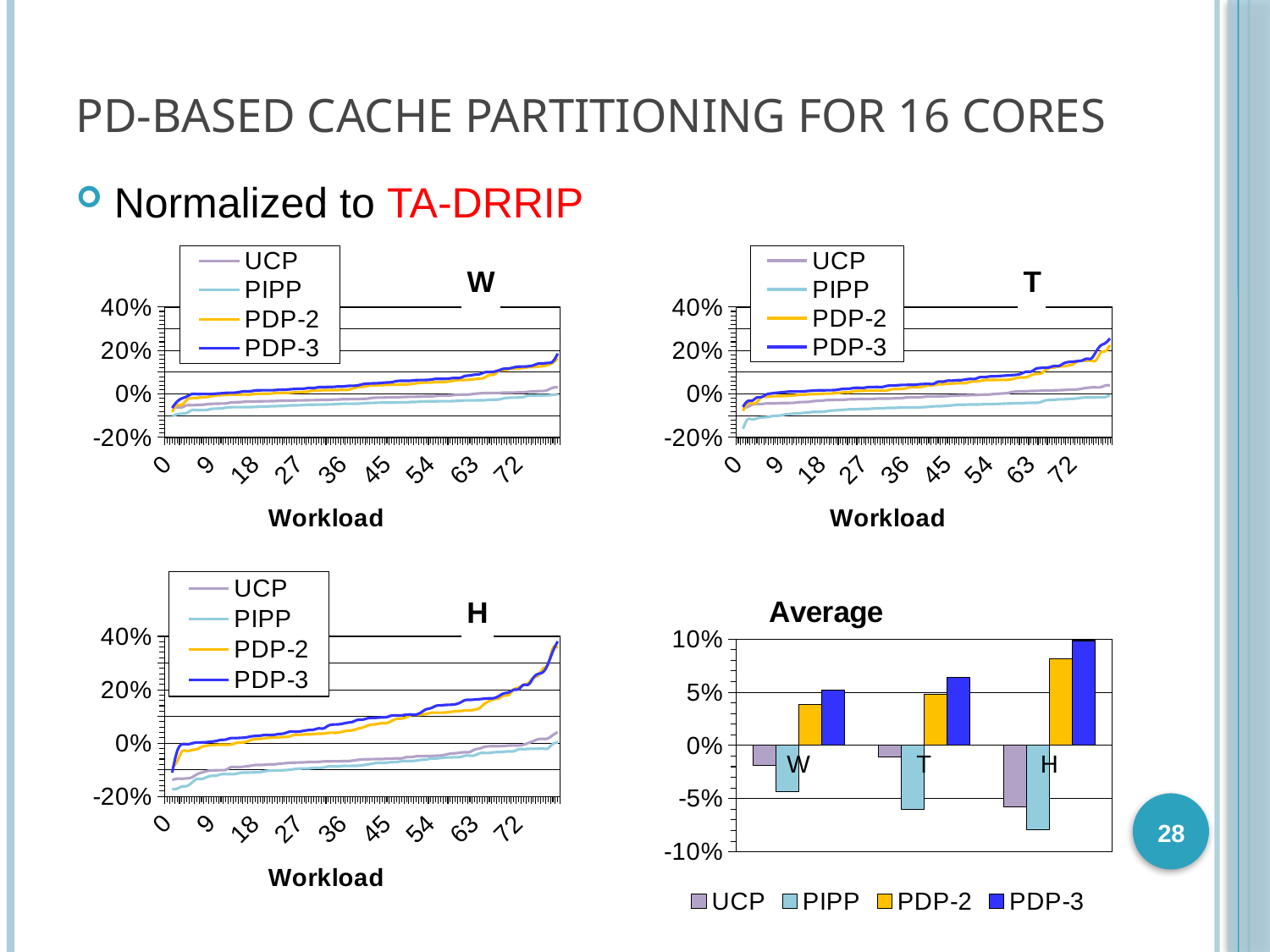
In the chart titled T, do the PDP-3 values rise or fall along the x axis? rise In the Average chart, for which category is the PIPP bar lowest? H How many series does the legend of the Average chart list? 4 How many series does the legend of the chart titled H list? 4 What kind of chart is the Average chart? bar chart What kind of chart is the chart titled W? line chart In the Average chart, is the PDP-3 value for H greater or less than 5%? greater In the Average chart, is the PIPP value for H greater or less than -5%? less In the Average chart, for which category is the PDP-3 bar highest? H How many categories are shown on the x axis of the Average chart? 3 In the Average chart, which is larger for W: PDP-2 or PDP-3? PDP-3 What is the x-axis title of the chart titled H? Workload